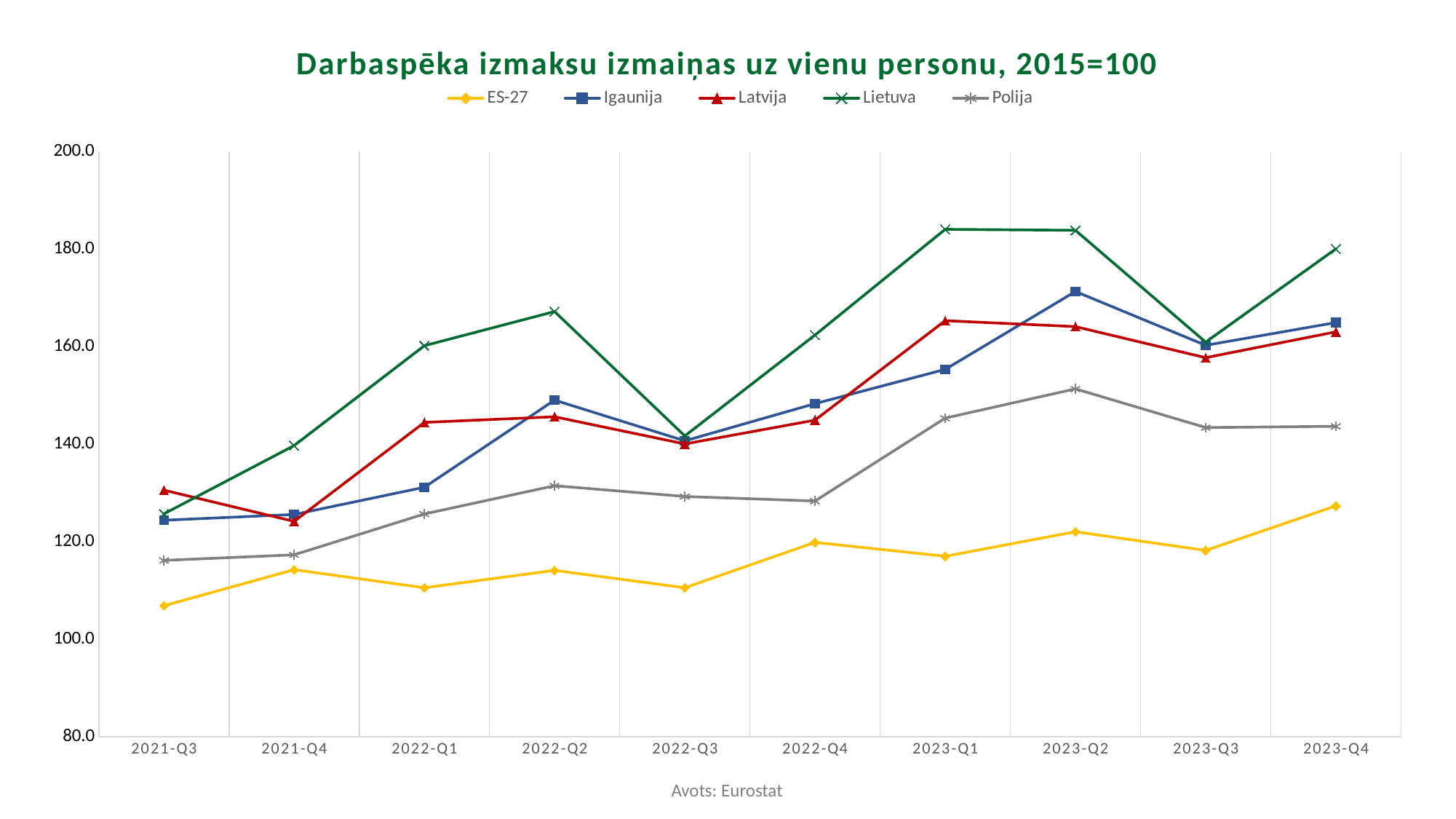
Is the value for Lietuva at 2023-Q1 greater or less than 180? greater How many series does the legend list? 5 Which series has the highest value at 2023-Q1? Lietuva What is the title of the chart? Darbaspēka izmaksu izmaiņas uz vienu personu, 2015=100 What kind of chart is shown on the slide? line chart Is the value for Polija at 2022-Q2 greater or less than 140? less What source is cited below the chart? Avots: Eurostat Is the value for ES-27 at 2021-Q3 greater or less than 120? less At 2023-Q2, which is larger: the value for Igaunija or the value for Latvija? Igaunija How many quarters are shown on the x axis? 10 Does the value for Lietuva rise or fall from 2022-Q2 to 2022-Q3? fall Which series has the lowest value at 2023-Q4? ES-27